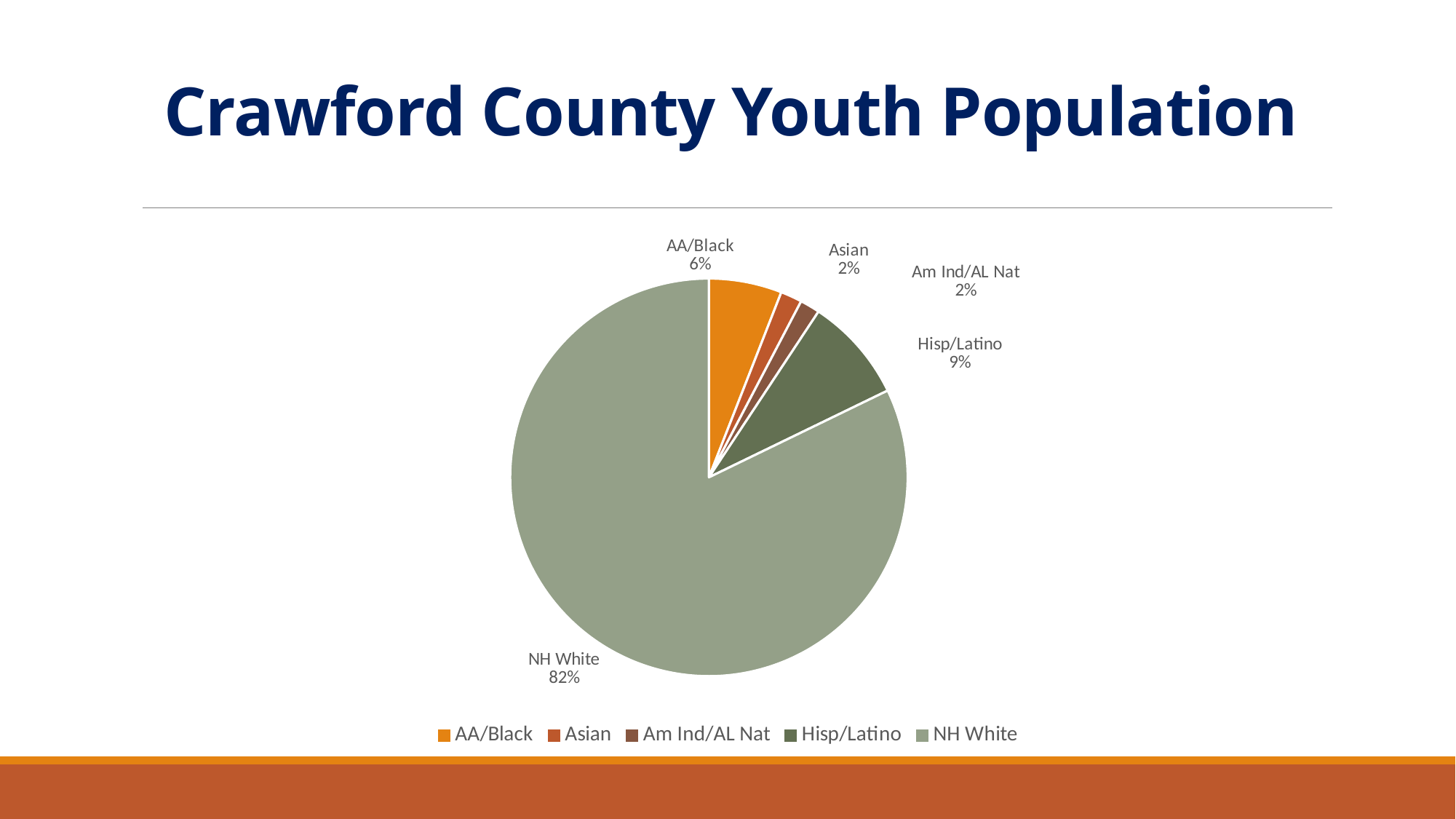
What share of the Crawford County youth population is Hisp/Latino? 9% Which category has the largest slice of the pie? NH White How many categories does the pie chart show? 5 What share of the Crawford County youth population is Am Ind/AL Nat? 2% What is the difference in percentage points between the NH White share and the Hisp/Latino share? 73 What is the title of the chart? Crawford County Youth Population Which is larger, the Hisp/Latino slice or the AA/Black slice? Hisp/Latino What share of the Crawford County youth population is AA/Black? 6% What kind of chart is shown on the slide? pie chart What colour is the NH White slice in the legend? grey-green